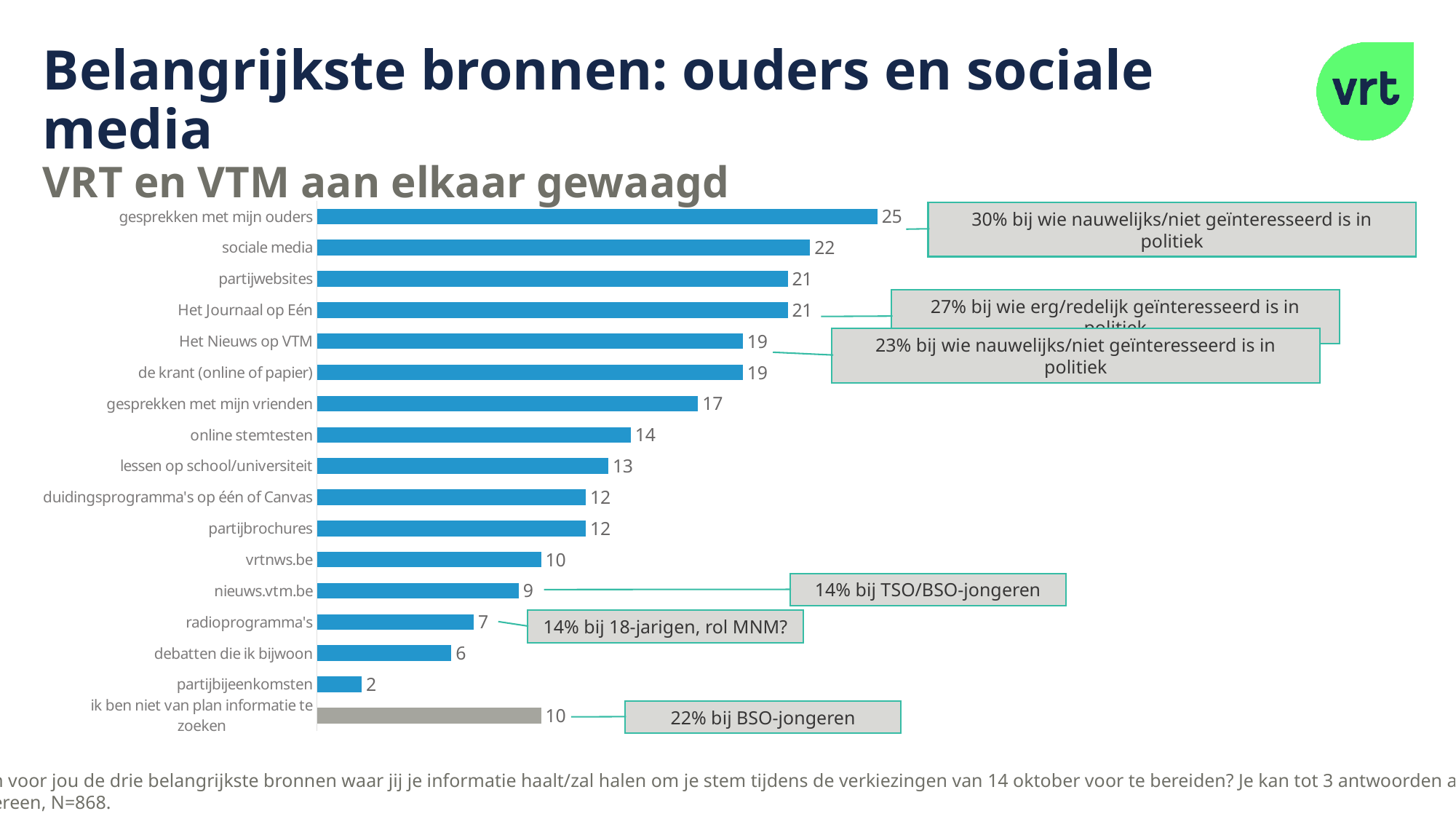
What is the difference between the values for 'de krant (online of papier)' and 'vrtnws.be'? 9 What value is shown for 'ik ben niet van plan informatie te zoeken'? 10 What is the difference between the values for 'gesprekken met mijn ouders' and 'sociale media'? 3 How many categories (bars) are shown in the chart? 17 Which has a higher value: 'online stemtesten' or 'lessen op school/universiteit'? online stemtesten Which bar in the chart is coloured grey instead of blue? ik ben niet van plan informatie te zoeken What value is shown for 'gesprekken met mijn ouders'? 25 What value is shown for 'sociale media'? 22 What value is shown for 'Het Nieuws op VTM'? 19 What type of chart is shown on the slide? bar chart Which category has the highest value in the chart? gesprekken met mijn ouders Which category has the lowest value in the chart? partijbijeenkomsten